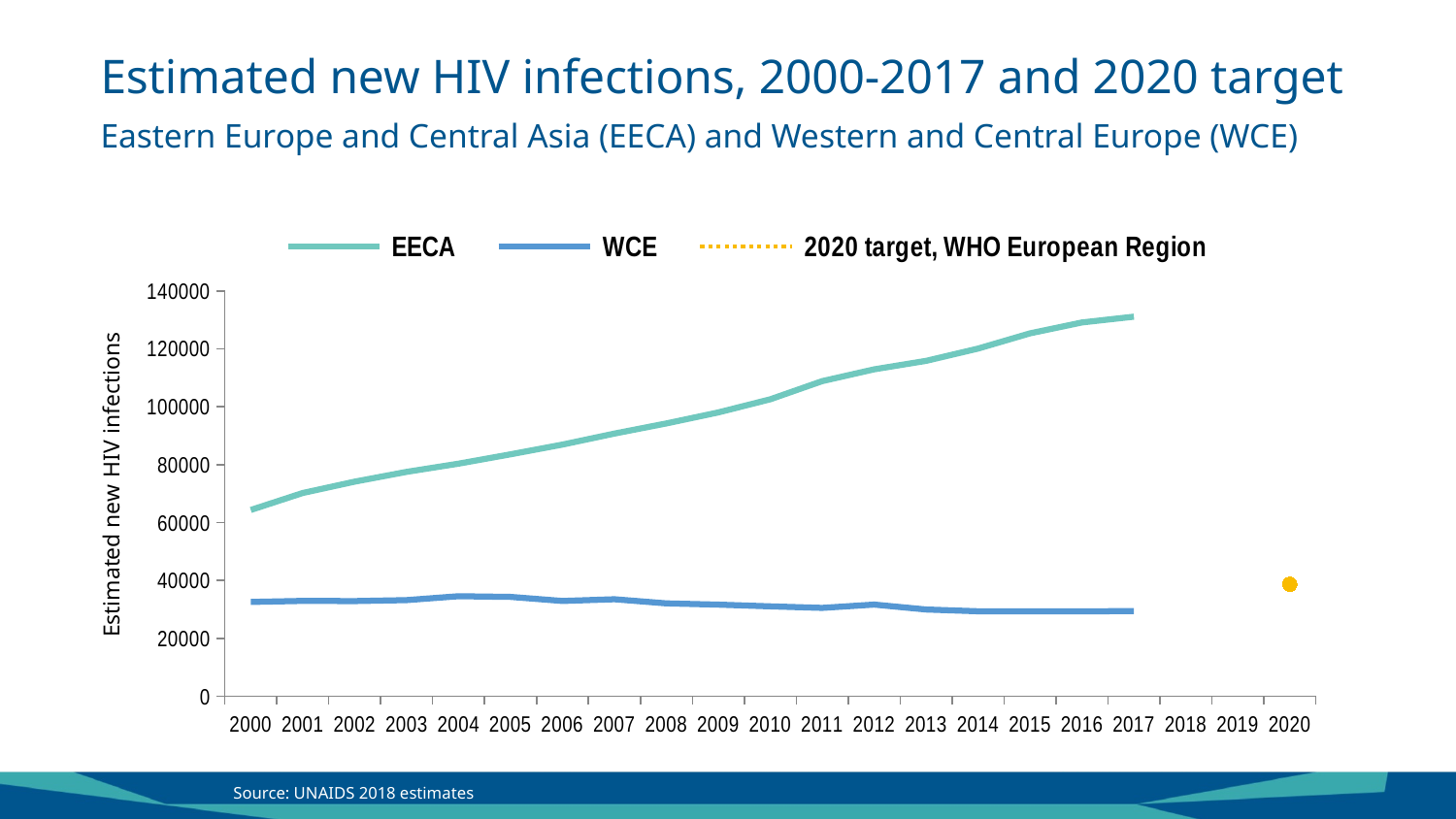
Is the 2020 target, WHO European Region value greater or less than 60000? less Do the EECA values rise or fall from 2000 to 2017? rise How many series does the legend list? 3 Is the EECA value for 2017 greater or less than 120000? greater In which year does the EECA series reach its highest value? 2017 What kind of chart is shown on the slide? line chart Is the EECA value for 2000 greater or less than 80000? less Do the WCE values rise or fall from 2000 to 2017? fall In 2010, which series has the larger value, EECA or WCE? EECA What is the label on the y axis? Estimated new HIV infections How many years are labelled on the x axis? 21